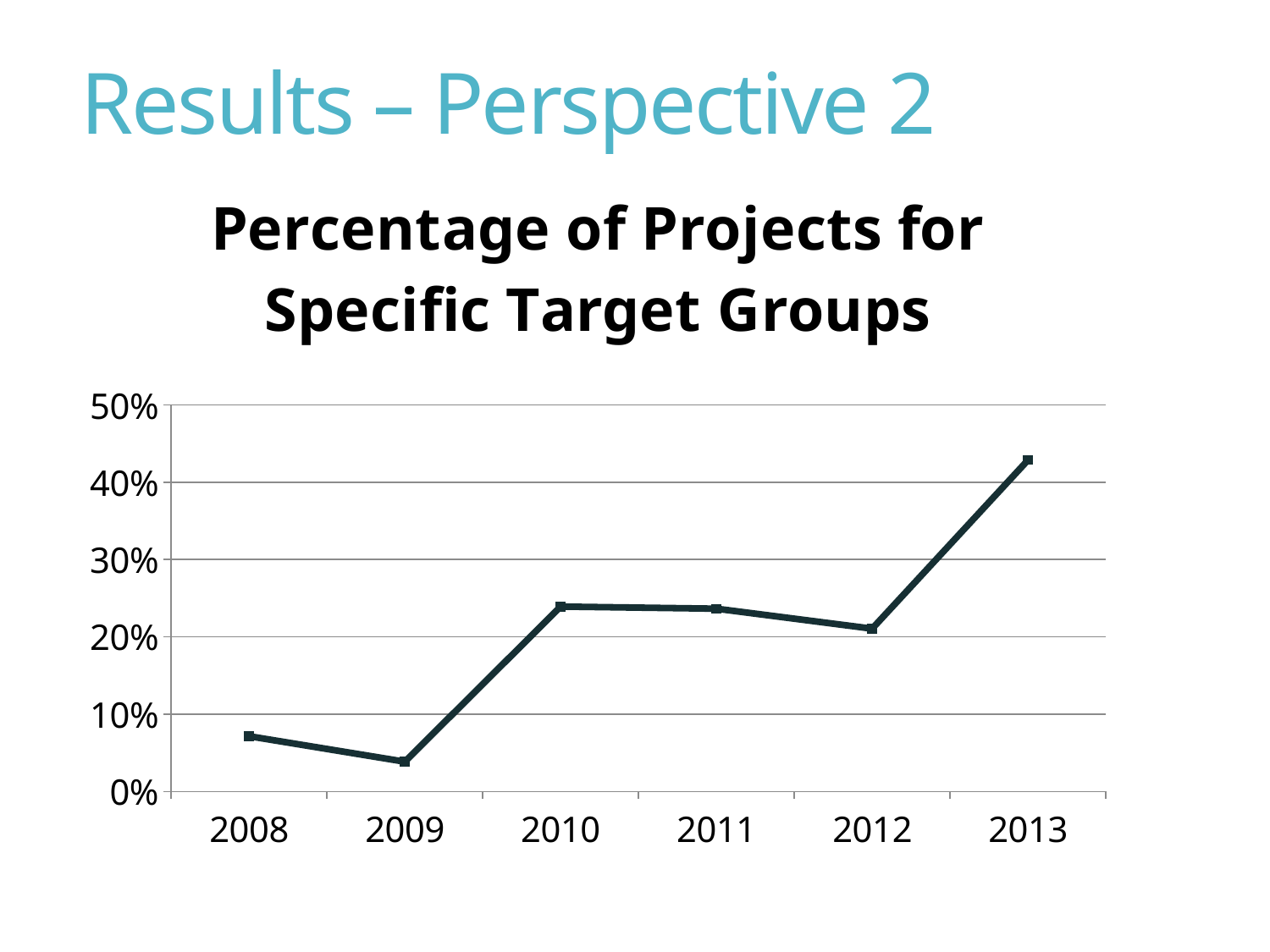
Is the value for 2009 greater or less than 10%? less Does the value rise or fall from 2012 to 2013? rise Which year has the lowest percentage of projects for specific target groups? 2009 Which year has the larger value, 2008 or 2013? 2013 Is the value for 2011 greater or less than 30%? less Is the value for 2010 greater or less than 20%? greater How many years are plotted on the x axis? 6 What kind of chart is shown on the slide? line chart Which year has the highest percentage of projects for specific target groups? 2013 What is the title of the chart? Percentage of Projects for Specific Target Groups